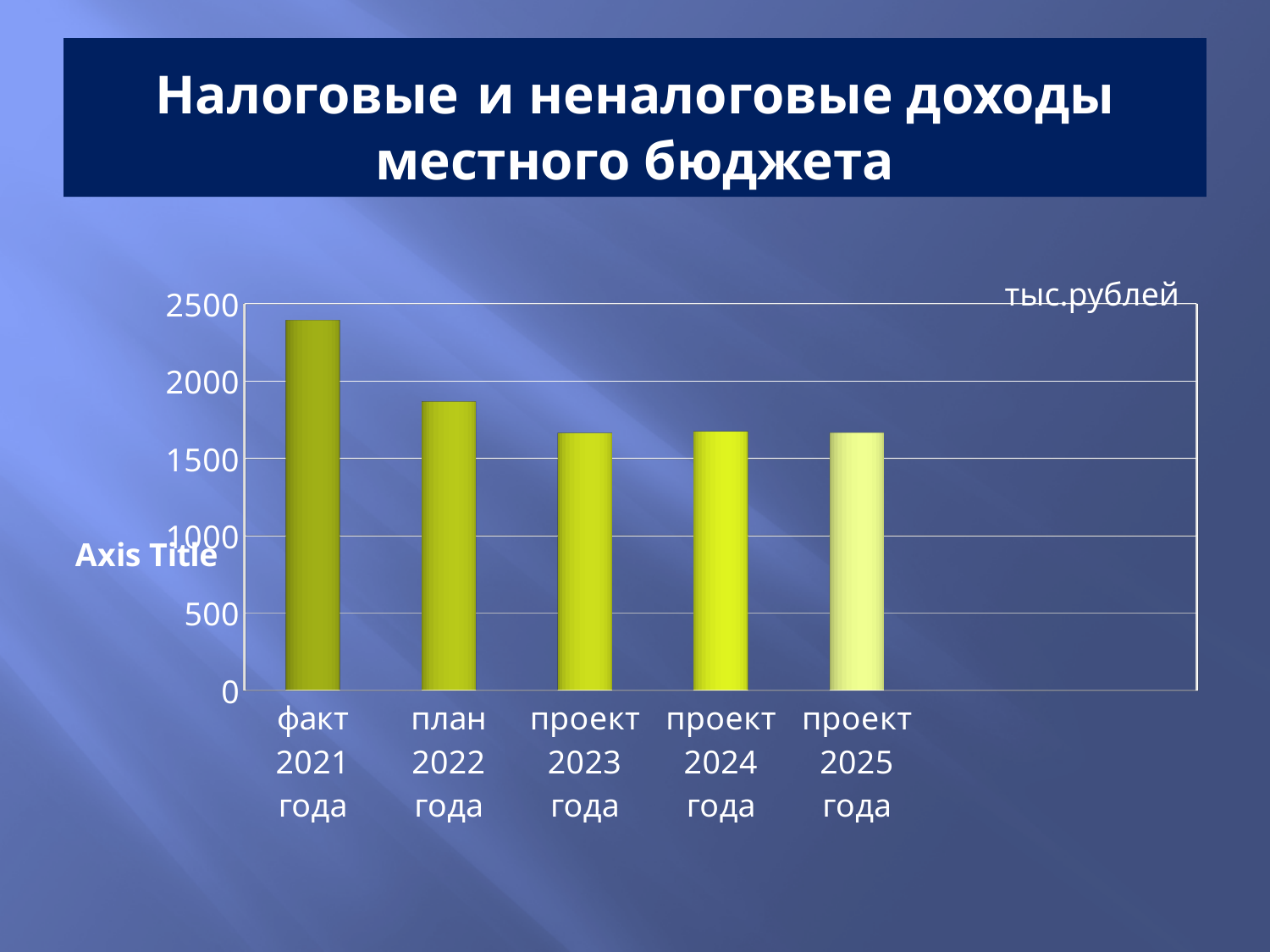
Is the value for проект 2023 года greater or less than 1500? greater How many categories (bars) are shown on the chart? 5 Is the value for проект 2025 года greater or less than 2000? less What kind of chart is shown on the slide? bar chart Is the value for план 2022 года greater or less than 2000? less Do the values generally rise or fall from факт 2021 года to проект 2025 года? fall Which is larger, the value for факт 2021 года or the value for план 2022 года? факт 2021 года Which category has the highest value on the chart? факт 2021 года Which is larger, the value for план 2022 года or the value for проект 2023 года? план 2022 года What unit of measurement is indicated above the chart? тыс.рублей